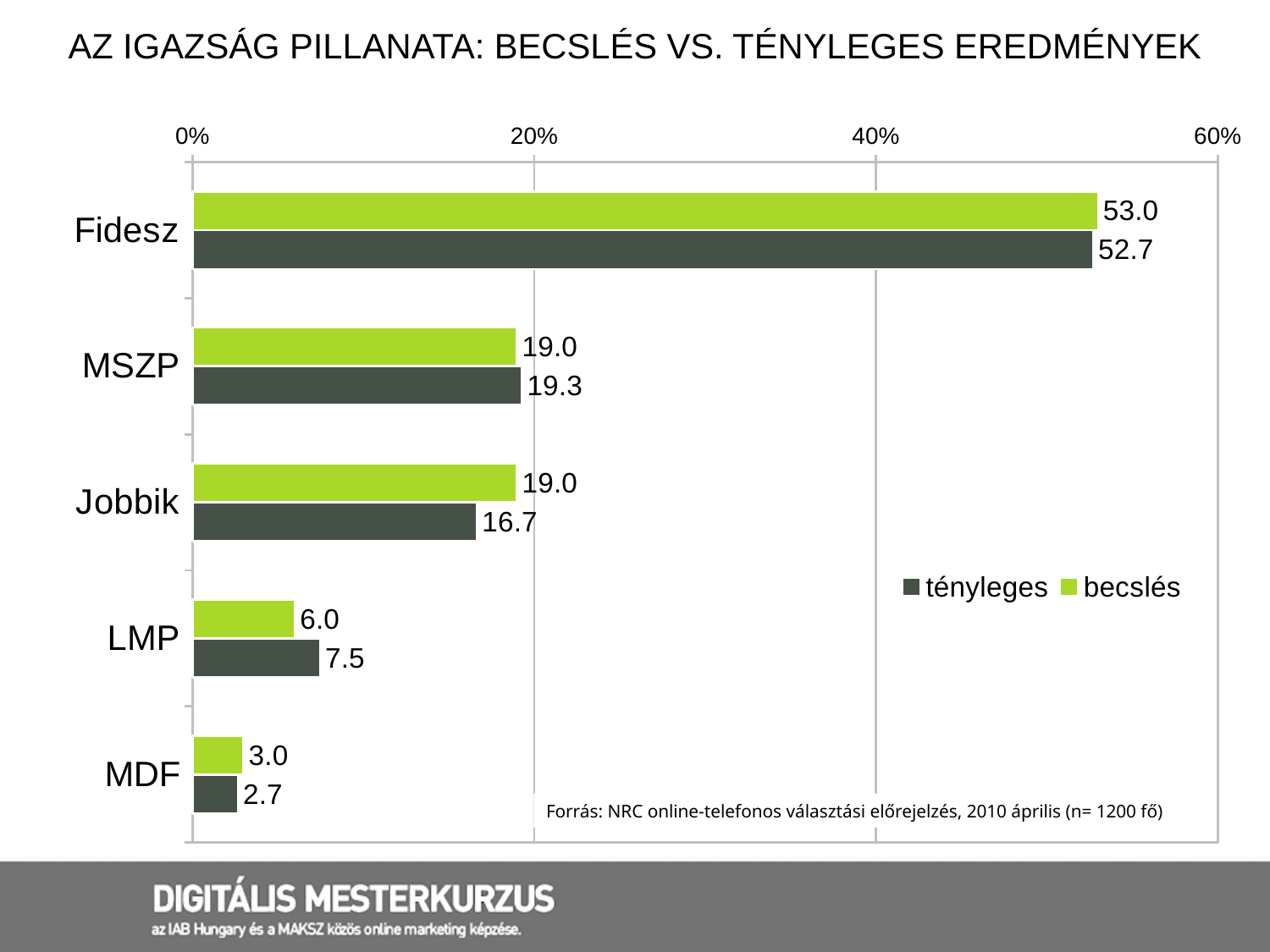
What is the tényleges (actual) value for Jobbik? 16.7 For LMP, which is larger: the becslés value or the tényleges value? tényleges What is the difference between the becslés and tényleges values for Jobbik? 2.3 How many series does the legend list? 2 What is the difference between the tényleges values for MSZP and Jobbik? 2.6 What is the tényleges value for LMP? 7.5 What is the becslés (estimate) value for Fidesz? 53.0 Is the tényleges value for Fidesz greater or less than 40%? greater How many parties are shown on the chart? 5 Which party has the highest tényleges value? Fidesz What kind of chart is shown on the slide? bar chart Which party has the lowest becslés value? MDF